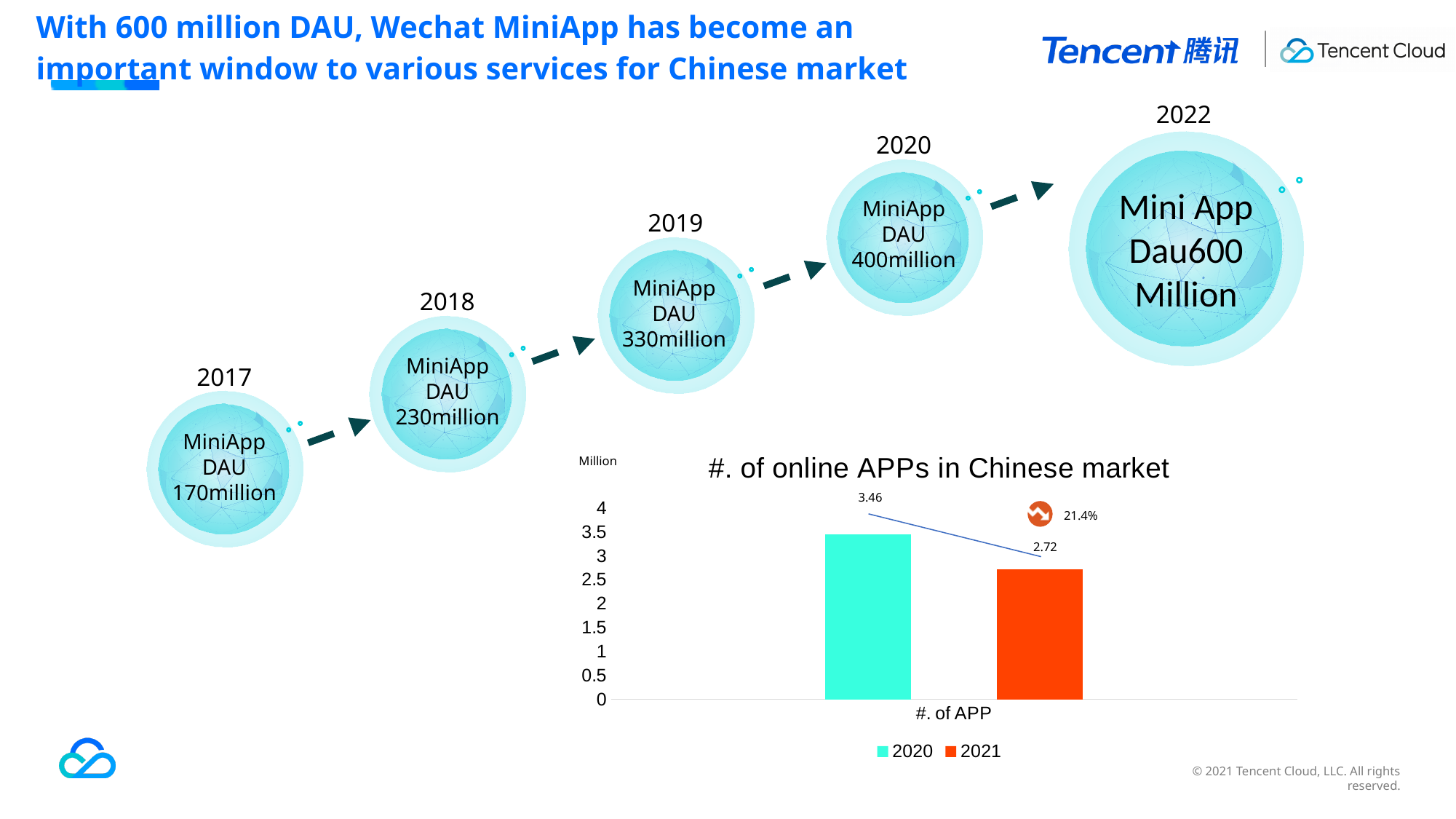
In the '#. of online APPs in Chinese market' chart, do the values rise or fall from 2020 to 2021? fall In the '#. of online APPs in Chinese market' chart, is the value for 2021 greater or less than 3? less In the '#. of online APPs in Chinese market' chart, what is the value for 2021? 2.72 In the '#. of online APPs in Chinese market' chart, which year has the higher value, 2020 or 2021? 2020 In the '#. of online APPs in Chinese market' chart, what is the value for 2020? 3.46 In the '#. of online APPs in Chinese market' chart, which series has the lowest value? 2021 What is the title of the bar chart on the slide? #. of online APPs in Chinese market What percentage change is annotated next to the 2021 bar in the '#. of online APPs in Chinese market' chart? 21.4% How many series does the legend of the '#. of online APPs in Chinese market' chart list? 2 In the '#. of online APPs in Chinese market' chart, what is the difference between the 2020 and 2021 values? 0.74 What type of chart is used for '#. of online APPs in Chinese market'? bar chart What unit is shown on the y axis of the '#. of online APPs in Chinese market' chart? Million